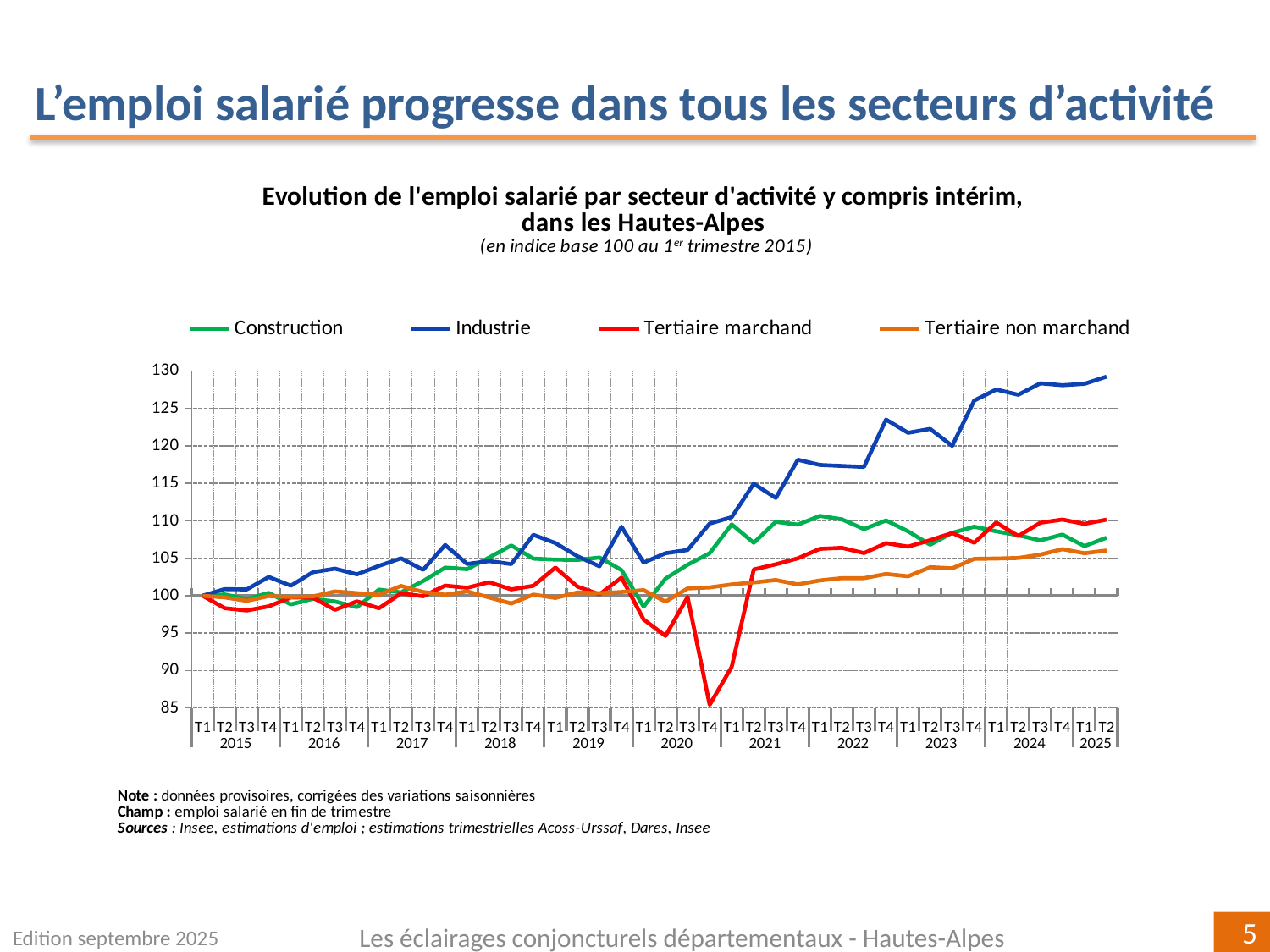
Does the Industrie series rise or fall overall from T1 2015 to T2 2025? rise Is the value for Tertiaire marchand at T4 2020 greater or less than 90? less Which series are listed in the legend? Construction, Industrie, Tertiaire marchand, Tertiaire non marchand Is the value for Tertiaire non marchand at T2 2025 greater or less than 110? less Is the value for Industrie at T2 2025 greater or less than 125? greater How many quarterly points are plotted along the x axis, from T1 2015 to T2 2025? 42 How many series does the legend list? 4 Which series has the highest value at T2 2025? Industrie Which series has the lowest value at T4 2020? Tertiaire marchand At T2 2025, which is larger: Tertiaire marchand or Tertiaire non marchand? Tertiaire marchand What kind of chart is shown on the slide? line chart According to the chart subtitle, what is the base period of the index (base 100)? 1er trimestre 2015